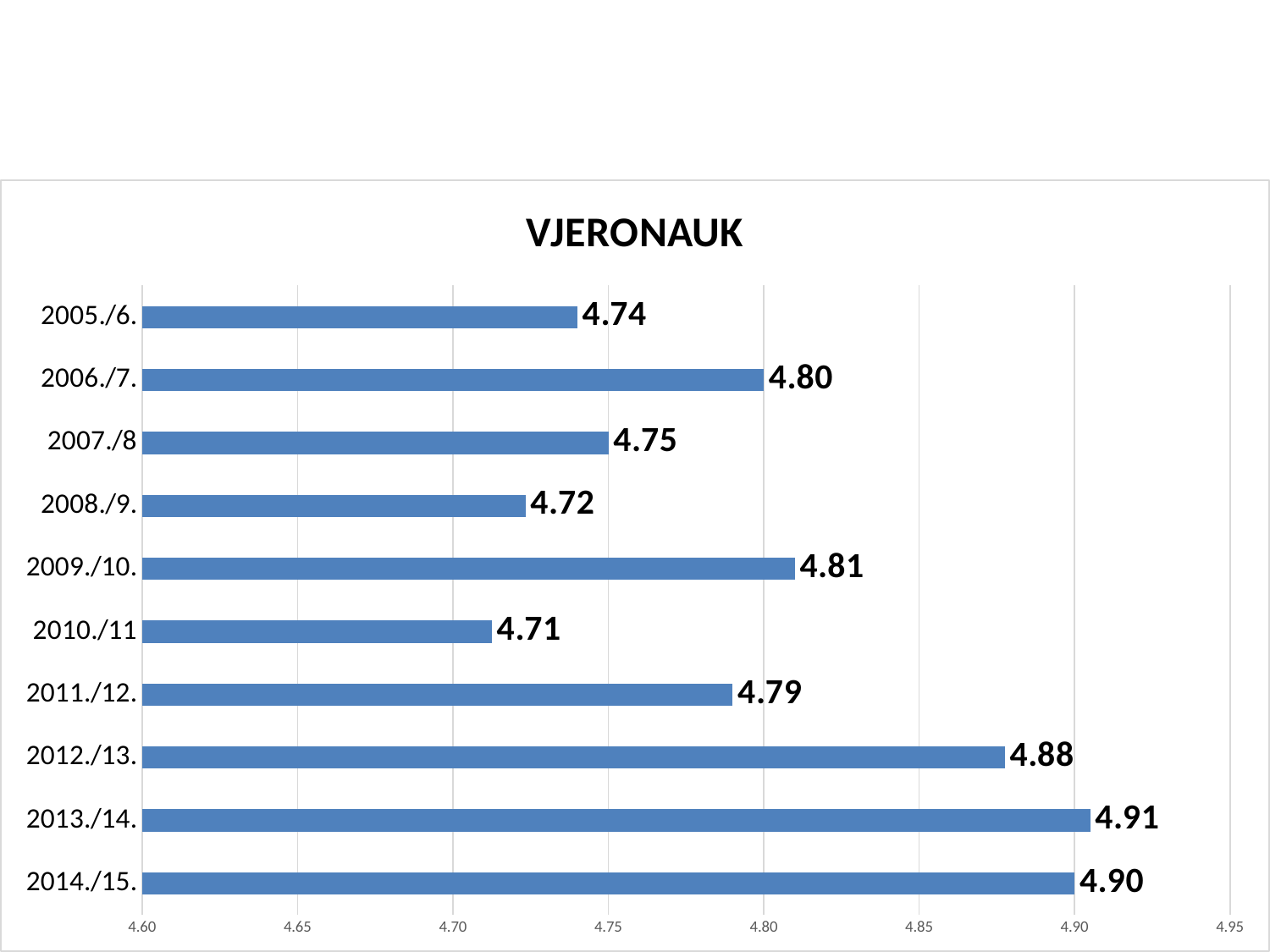
Which school year has the highest value? 2013./14. How many school years are shown in the chart? 10 What kind of chart is shown? bar chart What is the title of the chart? VJERONAUK Which school year has the lowest value? 2010./11 What is the value for 2005./6.? 4.74 What is the value for 2009./10.? 4.81 Is the value for 2014./15. greater or less than 4.85? greater What is the value for 2012./13.? 4.88 What is the difference between the values for 2013./14. and 2010./11? 0.20 Which is larger, the value for 2011./12. or the value for 2008./9.? 2011./12. What is the difference between the values for 2006./7. and 2005./6.? 0.06